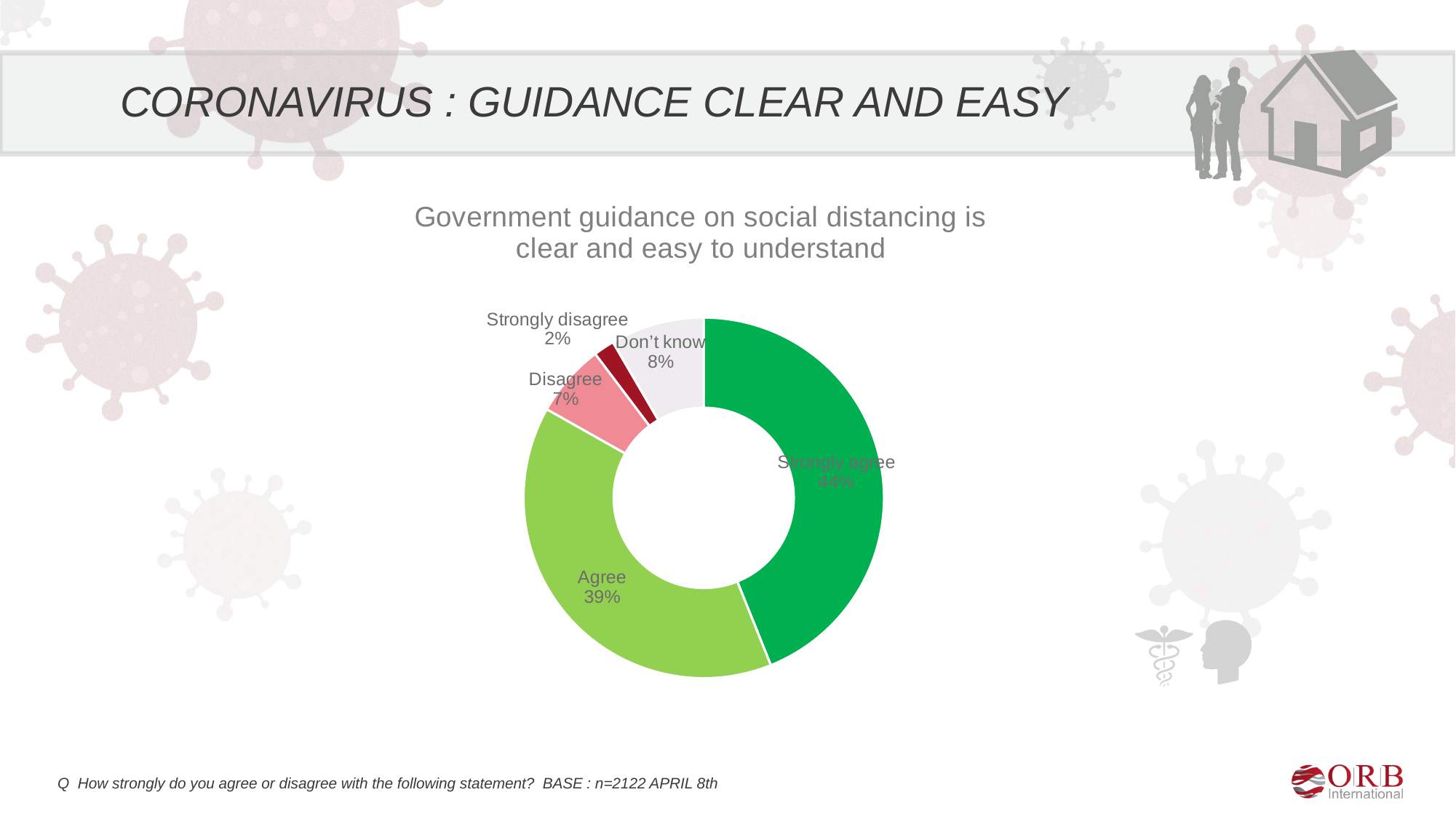
What is the difference in percentage points between 'Strongly agree' and 'Agree'? 5 Which response category has the largest share of the pie? Strongly agree What is the combined percentage of respondents who 'Strongly agree' or 'Agree'? 83% What percentage of respondents strongly agree that government guidance on social distancing is clear and easy to understand? 44% How many response categories are shown in the chart? 5 What percentage of respondents answered 'Don't know'? 8% Which is larger, the share for 'Don't know' or the share for 'Disagree'? Don't know Which response category has the smallest share of the pie? Strongly disagree What percentage of respondents answered 'Agree'? 39% What kind of chart is used on this slide? Pie chart (doughnut) What percentage of respondents answered 'Strongly disagree'? 2% What percentage of respondents answered 'Disagree'? 7%